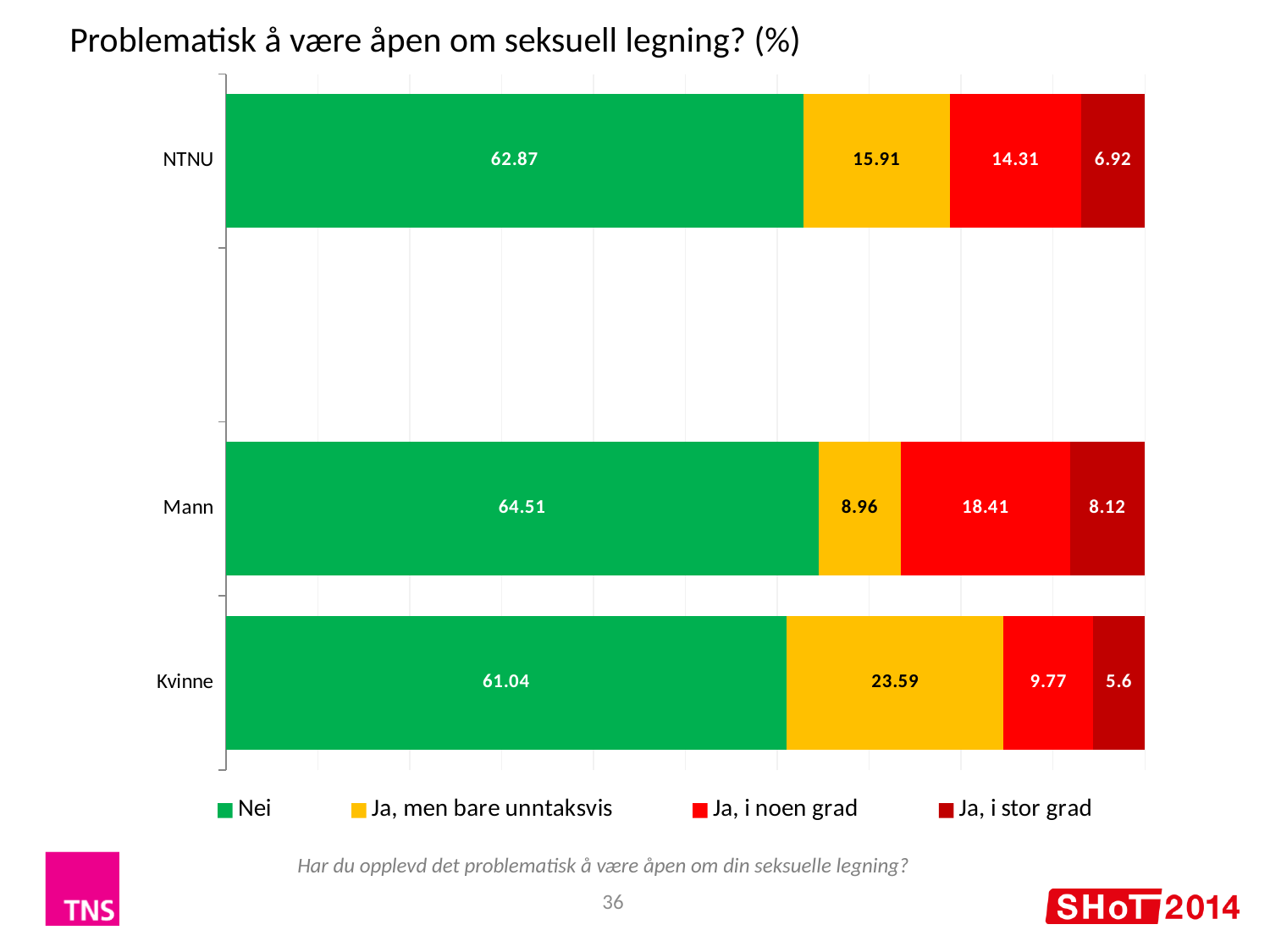
How many series does the legend list? 4 What is the value for "Ja, i noen grad" for Mann? 18.41 What kind of chart is shown on the slide? Stacked bar chart What is the difference between the "Ja, men bare unntaksvis" values for Kvinne and Mann? 14.63 What is the value for "Ja, i stor grad" for Kvinne? 5.6 What is the value for "Ja, men bare unntaksvis" for Kvinne? 23.59 Which category has the lowest value for "Ja, i stor grad"? Kvinne What is the value for "Nei" for NTNU? 62.87 Which category has the highest value for "Nei"? Mann Which is larger: the "Ja, i noen grad" value for Mann or for Kvinne? Mann What is the total of the stacked bar for Mann? 100 How many categories are shown on the chart? 3